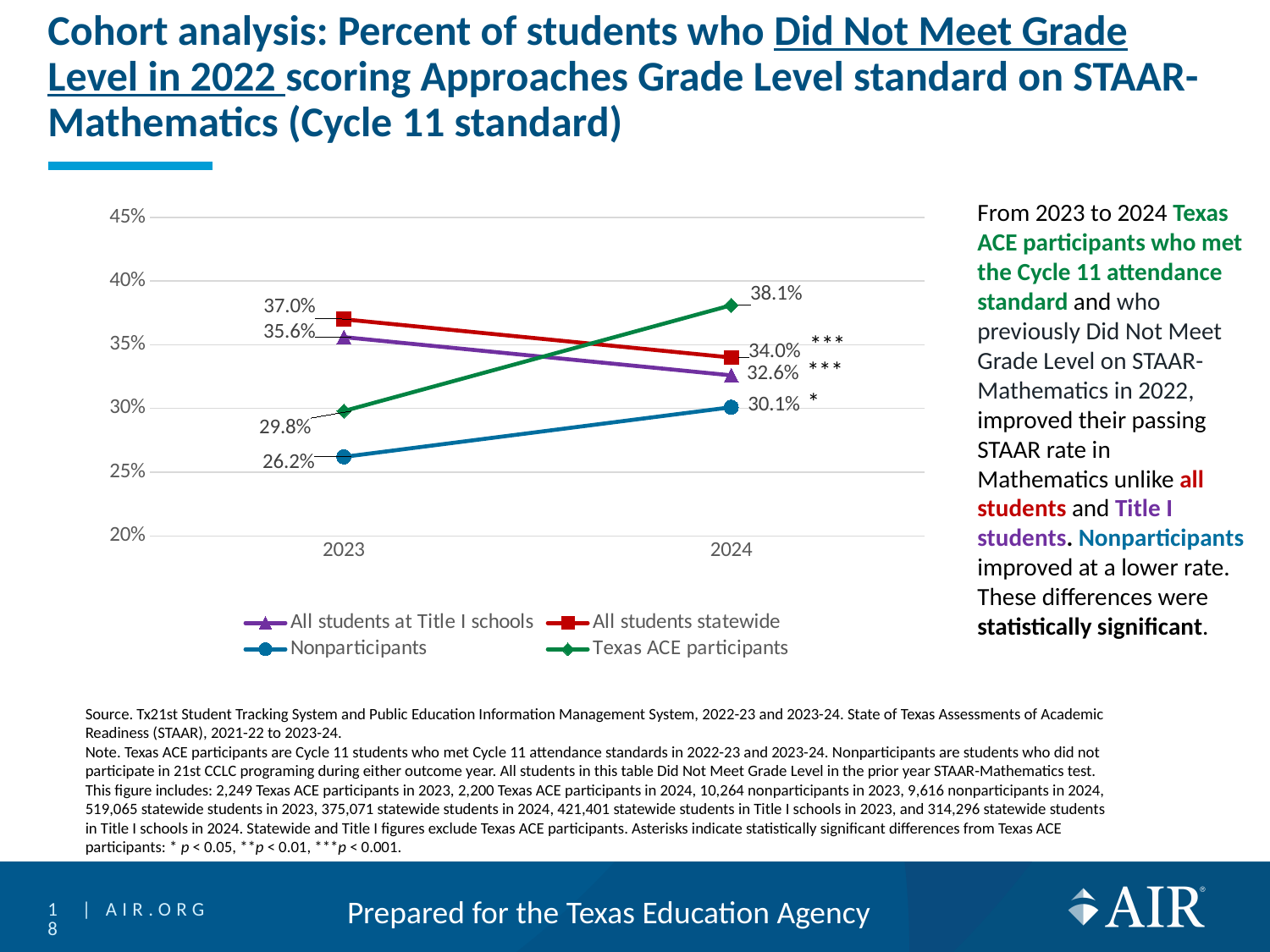
Which series had the lowest value in 2023? Nonparticipants What was the value for All students statewide in 2023? 37.0% By how many percentage points did the Texas ACE participants value change from 2023 to 2024? 8.3 percentage points In 2024, which was larger: the value for All students statewide or the value for Nonparticipants? All students statewide What was the value for All students at Title I schools in 2024? 32.6% What type of chart is shown on the slide? Line chart Did the value for All students at Title I schools rise or fall from 2023 to 2024? Fall Which series had the highest value in 2024? Texas ACE participants What was the value for Texas ACE participants in 2024? 38.1% How many series does the legend list? 4 What was the value for Nonparticipants in 2023? 26.2% How many years are shown on the x axis? 2